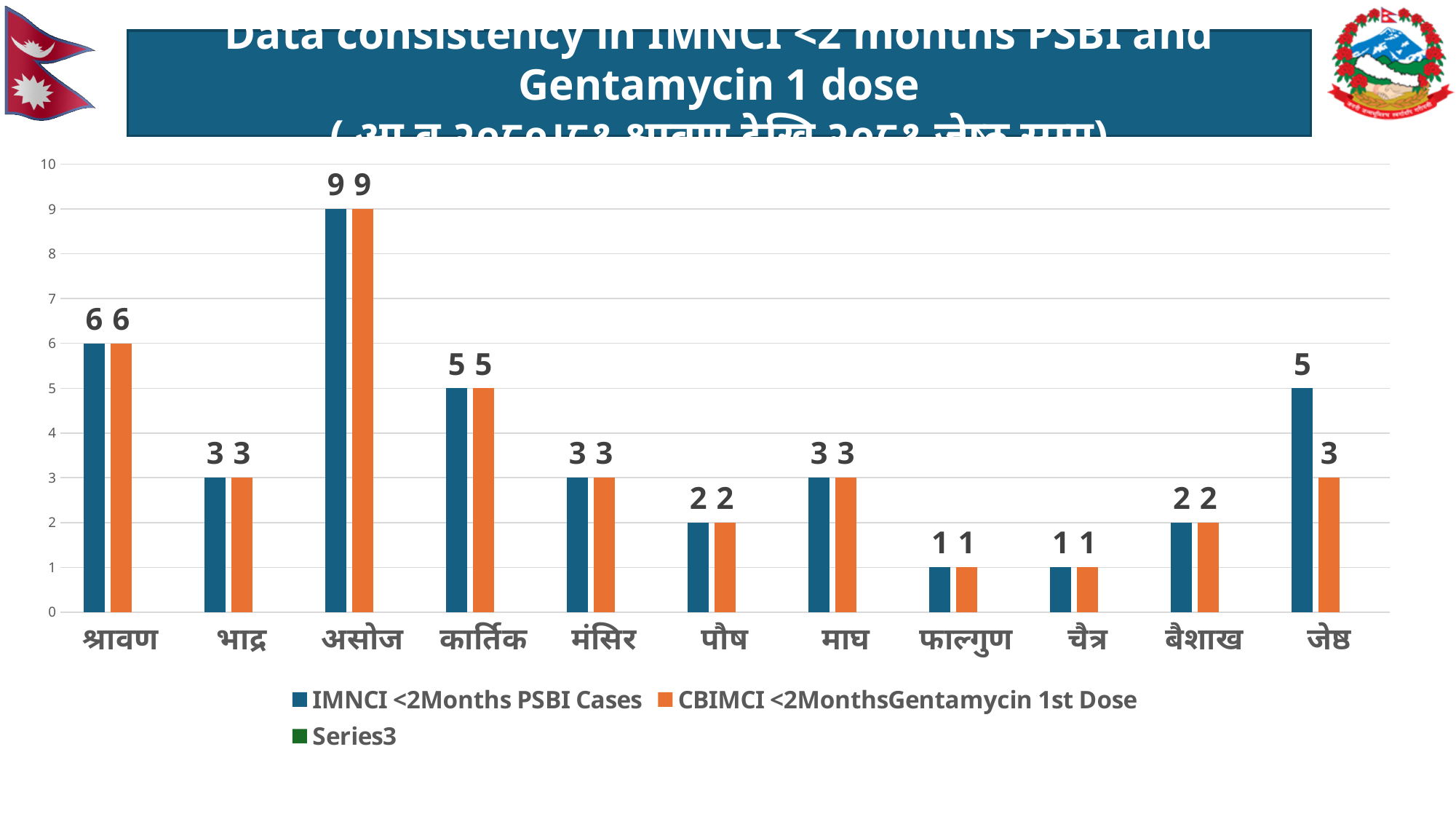
What is the value of CBIMCI <2MonthsGentamycin 1st Dose for जेष्ठ? 3 How many months are shown on the x axis of the chart? 11 What is the value of IMNCI <2Months PSBI Cases for श्रावण? 6 Which month has a higher value for IMNCI <2Months PSBI Cases: श्रावण or कार्तिक? श्रावण What is the value of CBIMCI <2MonthsGentamycin 1st Dose for कार्तिक? 5 What colour are the bars for CBIMCI <2MonthsGentamycin 1st Dose? Orange How many series does the legend list? 3 Which month has the highest value for IMNCI <2Months PSBI Cases? असोज What is the value of IMNCI <2Months PSBI Cases for असोज? 9 What is the difference between IMNCI <2Months PSBI Cases and CBIMCI <2MonthsGentamycin 1st Dose for जेष्ठ? 2 Which is larger for जेष्ठ: IMNCI <2Months PSBI Cases or CBIMCI <2MonthsGentamycin 1st Dose? IMNCI <2Months PSBI Cases What kind of chart is shown on the slide? Bar chart